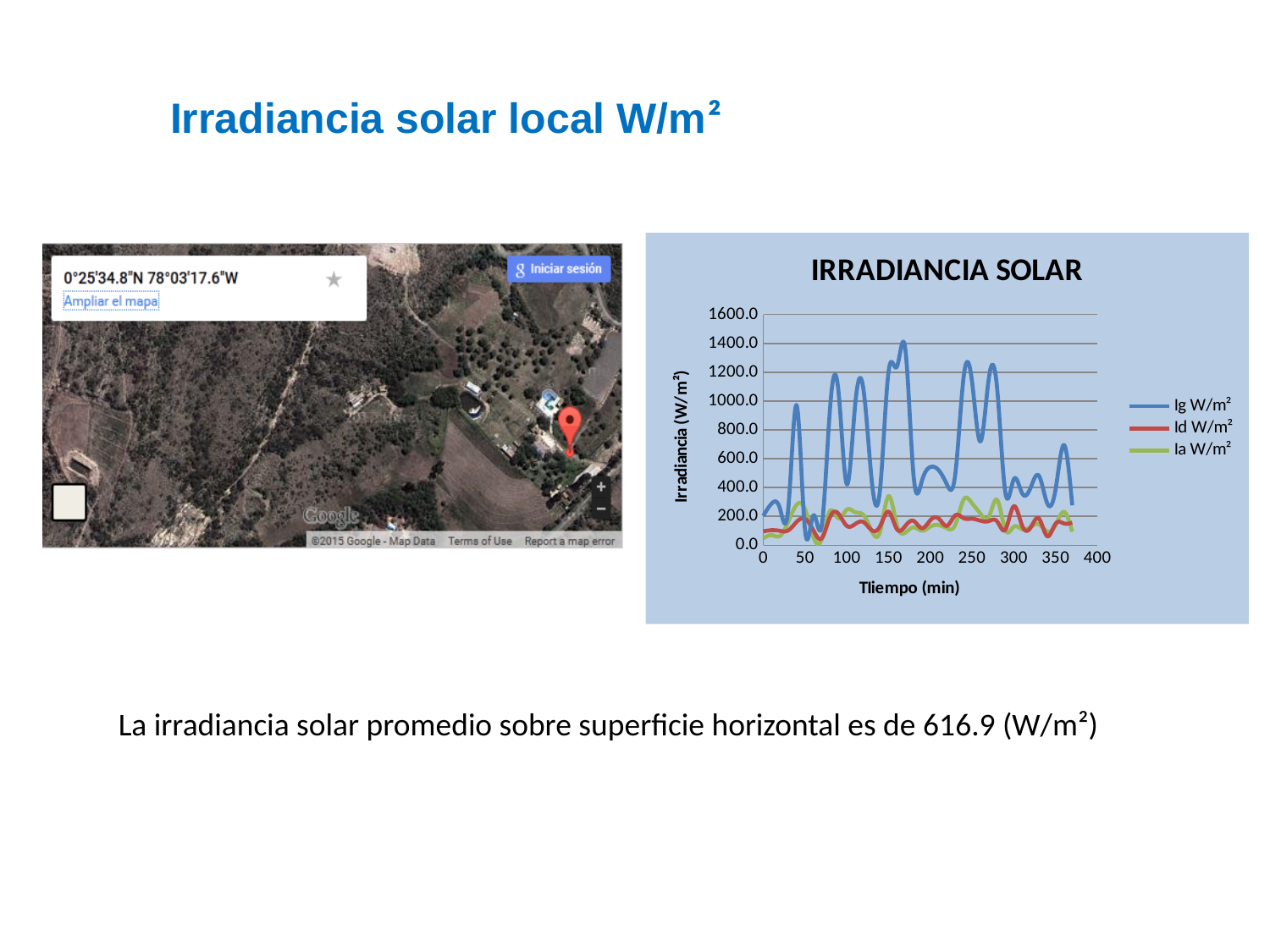
What is the maximum value shown on the y axis of the IRRADIANCIA SOLAR chart? 1600.0 What is the title of the chart on the slide? IRRADIANCIA SOLAR At around 170 minutes, which series has the larger value, Ig W/m² or Id W/m²? Ig W/m² Is the highest value of the Id W/m² series greater or less than 400? less How many series does the legend of the IRRADIANCIA SOLAR chart list? 3 Is the peak value of the Ig W/m² series greater or less than 1200? greater What kind of chart is shown on the slide? line chart Which series in the IRRADIANCIA SOLAR chart reaches the highest values? Ig W/m² What is the label of the x axis of the IRRADIANCIA SOLAR chart? Tliempo (min) Is the highest value of the Ia W/m² series greater or less than 600? less